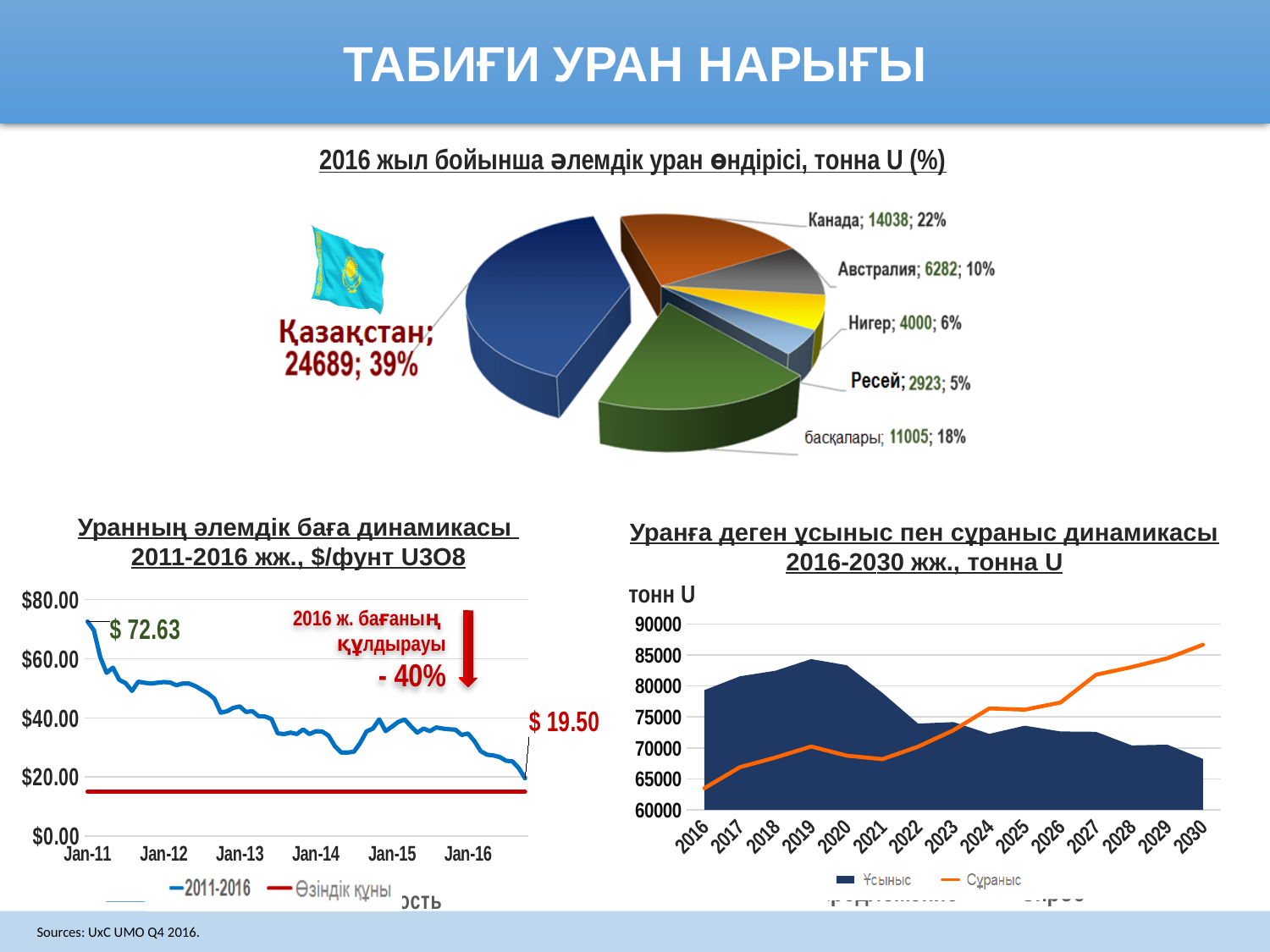
In the bottom-left chart of uranium price dynamics 2011-2016, what price is labelled at the start of the series? $ 72.63 In the pie chart of 2016 world uranium production, what is the difference in tonnes between Канада and Нигер? 10038 In the pie chart of 2016 world uranium production, what is the value in tonnes shown for Австралия? 6282 In the bottom-left chart of uranium price dynamics 2011-2016, do the values generally rise or fall along the x axis? fall In the pie chart of 2016 world uranium production, how many slices are there? 6 In the bottom-right chart of uranium supply and demand 2016-2030, is the value of Сұраныс in 2030 greater or less than 85000? greater In the pie chart of 2016 world uranium production, what share is shown for Канада? 22% In the pie chart of 2016 world uranium production, which labelled country has the smallest share? Ресей In the bottom-left chart of uranium price dynamics 2011-2016, what price is labelled at the end of the series? $ 19.50 In the bottom-right chart of uranium supply and demand 2016-2030, how many series does the legend list? 2 In the pie chart of 2016 world uranium production, which is larger, the value for Нигер or the value for Ресей? Нигер In the pie chart of 2016 world uranium production, what is the value shown for Қазақстан? 24689; 39%